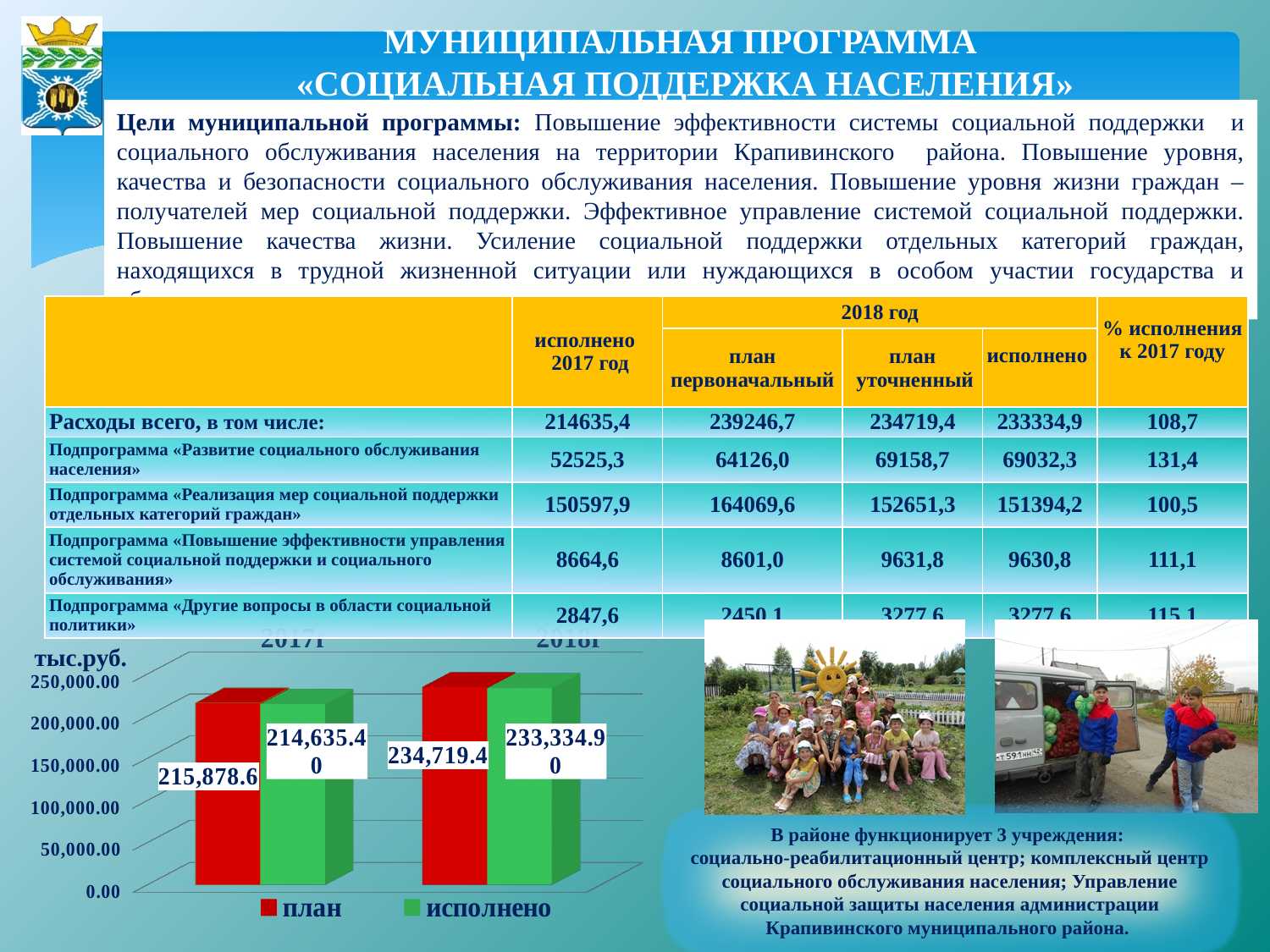
How many series does the legend of the bar chart list? 2 In the bar chart, does the план value rise or fall from 2017 to 2018? rise How many year groups are plotted in the bar chart? 2 In the bar chart at the bottom left, what is the value of the исполнено bar for 2018? 233,334.90 In the bar chart at the bottom left, what is the value of the план bar for 2017? 215,878.6 In the bar chart, which is larger: the план value for 2017 or the план value for 2018? план for 2018 In the bar chart at the bottom left, what is the value of the исполнено bar for 2017? 214,635.40 In the bar chart at the bottom left, what is the value of the план bar for 2018? 234,719.4 What are the two legend entries of the bar chart? план, исполнено What kind of chart is shown at the bottom left of the slide? bar chart In the bar chart, what is the difference between the план and исполнено values for 2018? 1,384.5 What unit is written above the vertical axis of the bar chart? тыс.руб.